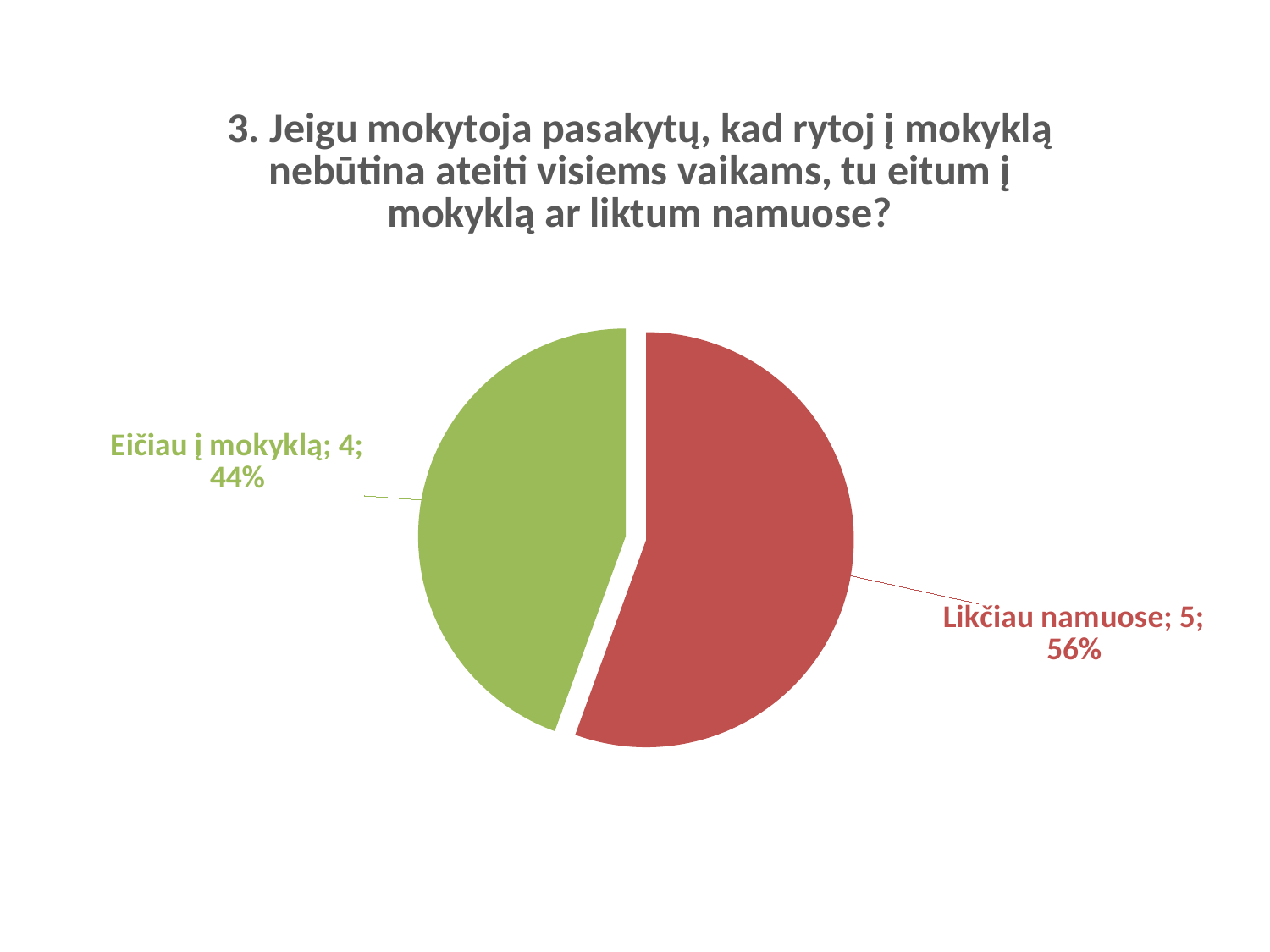
Which is larger, the slice for "Likčiau namuose" or the slice for "Eičiau į mokyklą"? Likčiau namuose Which category has the largest slice? Likčiau namuose Which category has the smallest slice? Eičiau į mokyklą What is the total count across both slices? 9 What is the count for "Likčiau namuose"? 5 How many slices does the pie chart have? 2 What share of the pie does "Eičiau į mokyklą" represent? 44% What is the count for "Eičiau į mokyklą"? 4 What is the difference in count between "Likčiau namuose" and "Eičiau į mokyklą"? 1 What share of the pie does "Likčiau namuose" represent? 56% What kind of chart is shown on the slide? pie chart What colour is the slice for "Eičiau į mokyklą"? green